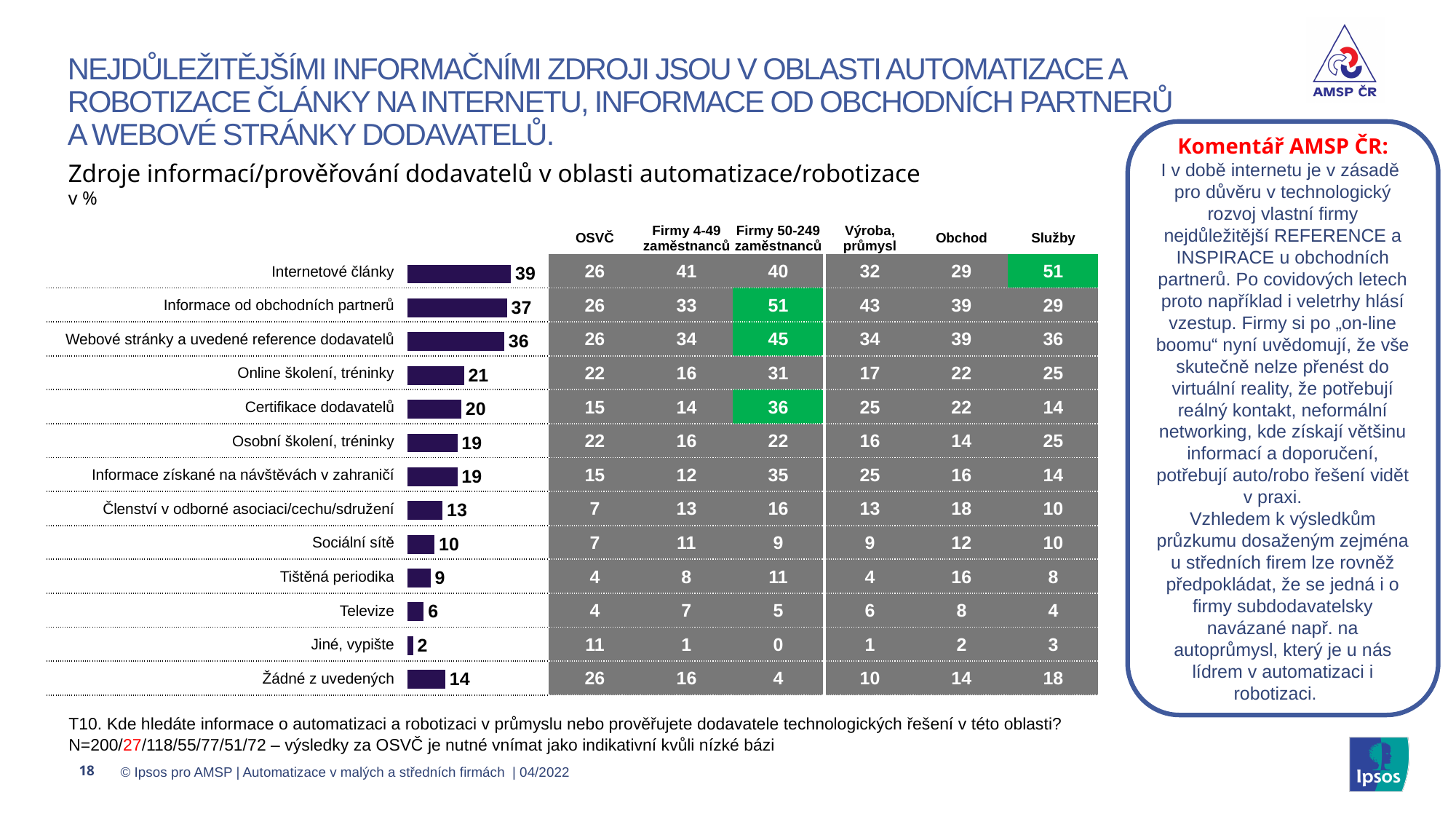
What unit is stated under the chart title? v % How many categories are shown in the bar chart? 13 What type of chart is shown on the slide? Bar chart What is the value for "Certifikace dodavatelů" in the bar chart? 20 Which category has the highest value in the bar chart? Internetové články What is the difference between the values for "Internetové články" and "Informace od obchodních partnerů" in the bar chart? 2 What is the value for "Internetové články" in the bar chart? 39 What is the difference between the values for "Online školení, tréninky" and "Sociální sítě" in the bar chart? 11 What is the value for "Žádné z uvedených" in the bar chart? 14 Which category has the lowest value in the bar chart? Jiné, vypište Which has a larger value in the bar chart, "Tištěná periodika" or "Televize"? Tištěná periodika Which has a larger value in the bar chart, "Členství v odborné asociaci/cechu/sdružení" or "Žádné z uvedených"? Žádné z uvedených